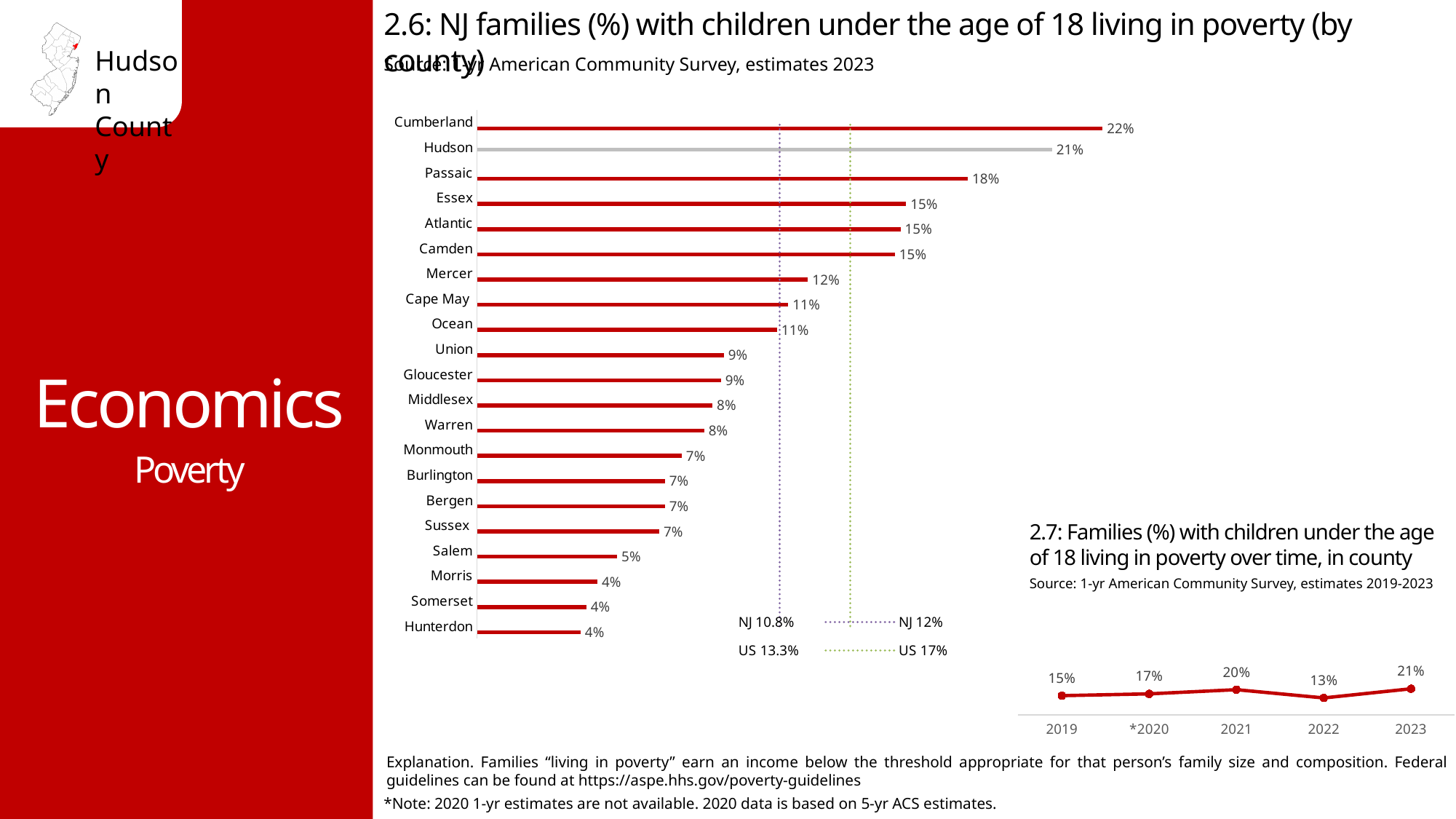
In chart 2.7, what is the difference between the 2023 value and the 2022 value? 8% What kind of chart is chart 2.6? Bar chart In chart 2.6, what is the value for Salem? 5% In chart 2.7, which year has the lowest value? 2022 In chart 2.6, what is the value for Passaic? 18% In chart 2.6 (NJ families with children under 18 living in poverty by county), what is the value for Hudson? 21% In chart 2.6, what is the difference between the values for Cumberland and Hudson? 1% In chart 2.7 (families with children under 18 living in poverty over time, in county), what is the value for 2021? 20% In chart 2.6, which is larger, the value for Mercer or the value for Union? Mercer In chart 2.6, how many counties are plotted? 21 In chart 2.6, which county has the highest percentage of families with children living in poverty? Cumberland